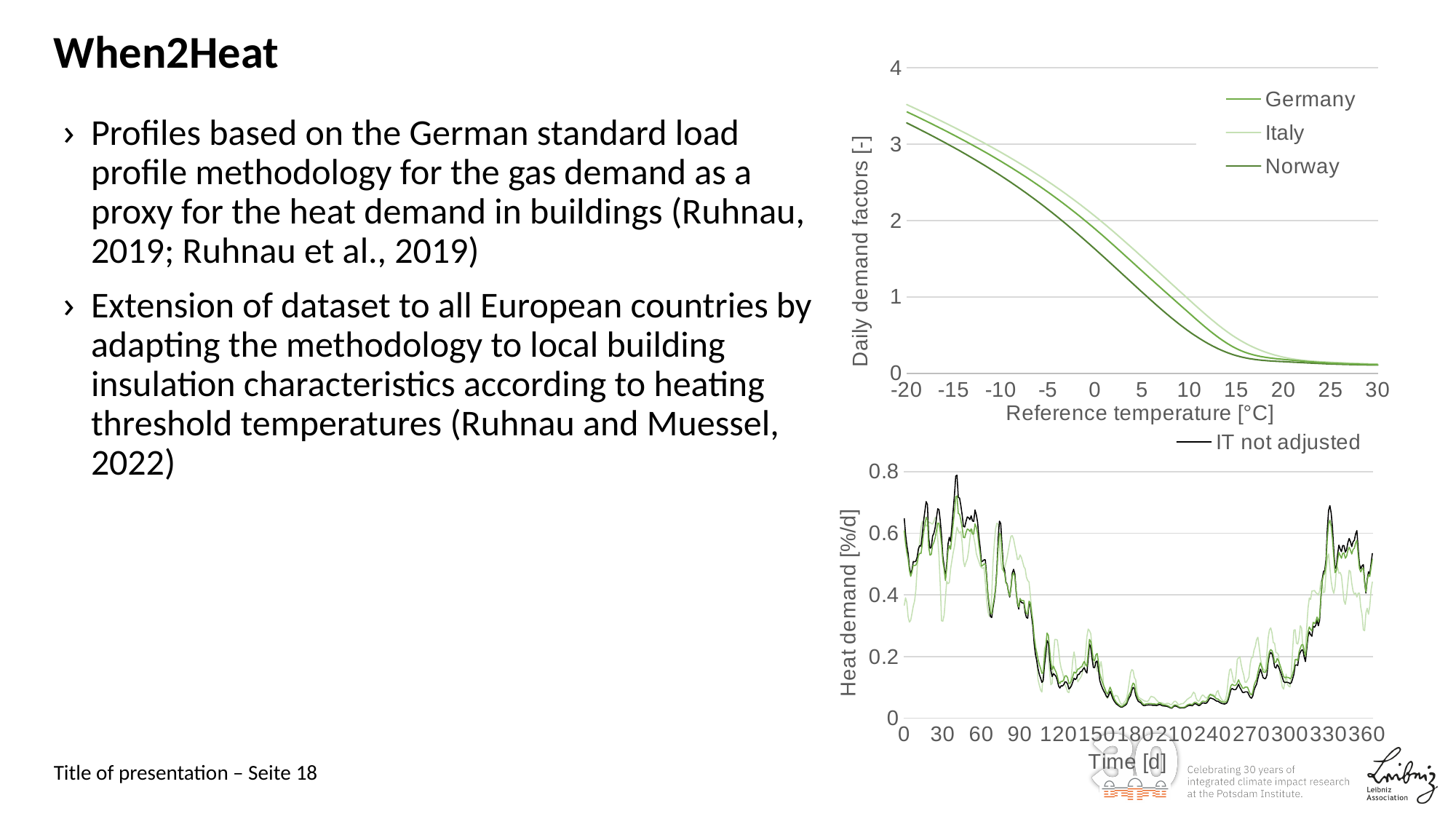
What kind of chart is the bottom chart on the slide (heat demand vs time)? line chart What kind of chart is the top chart on the slide (daily demand factors vs reference temperature)? line chart In the top chart, which series has the highest daily demand factor at a reference temperature of 10 °C? Italy How many series does the legend of the top chart list? 3 In the top chart, which series has the lowest daily demand factor at a reference temperature of 10 °C? Norway In the top chart, do the daily demand factors rise or fall as the reference temperature increases from -20 to 30 °C? fall In the bottom chart, is the peak value of the 'IT not adjusted' series greater or less than 0.6? greater In the top chart, is the daily demand factor for Norway at 10 °C greater or less than 1? less Which series are listed in the legend of the top chart? Germany, Italy, Norway In the top chart, at 10 °C, is the value for Italy or the value for Norway larger? Italy In the top chart, is the daily demand factor for Germany at -10 °C greater or less than 3? less What is the x-axis label of the bottom chart? Time [d]